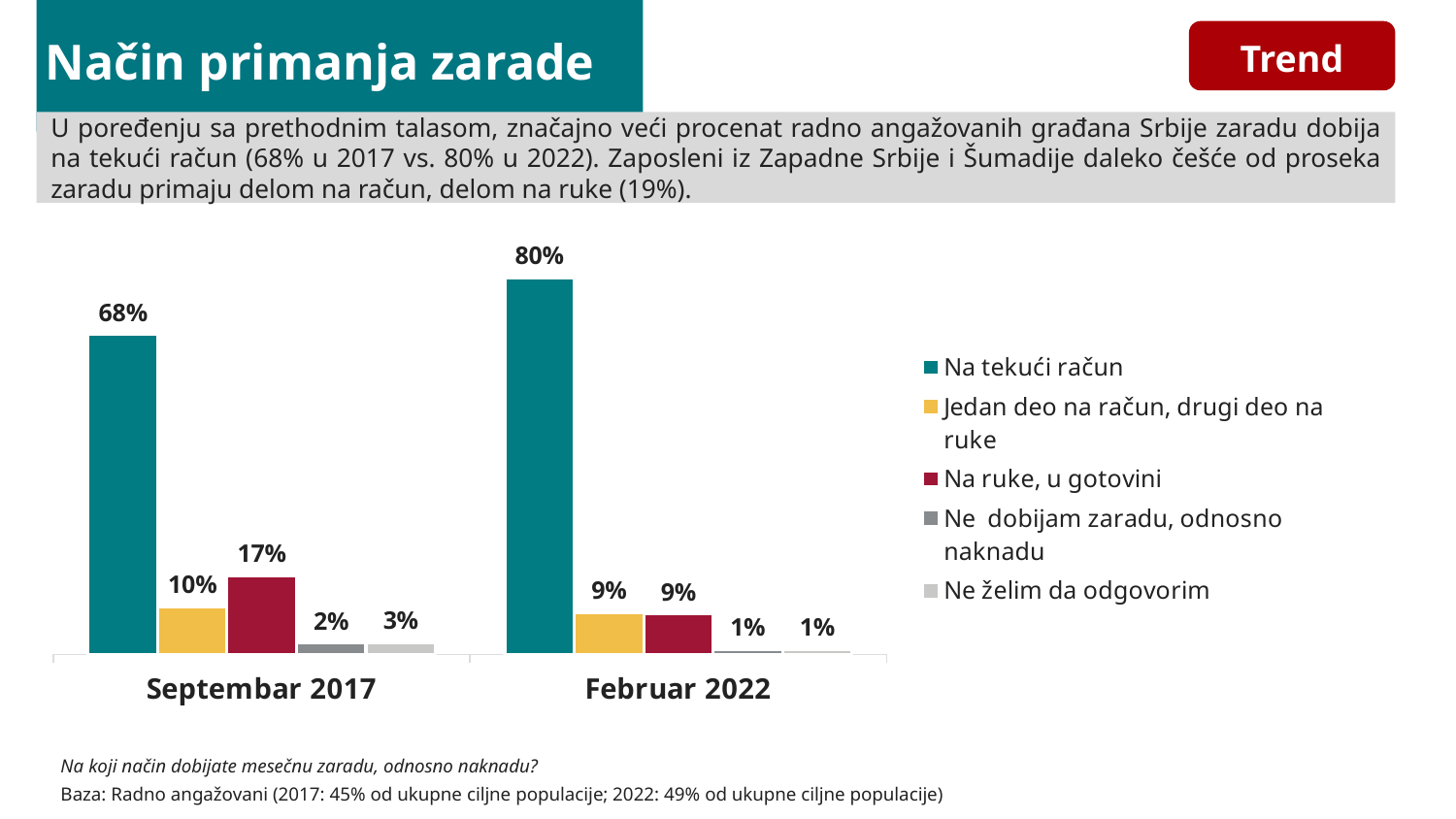
What is the value for "Ne želim da odgovorim" in Septembar 2017? 3% What kind of chart is shown on the slide? bar chart What is the difference between the "Na tekući račun" values for Februar 2022 and Septembar 2017? 12% What is the value for "Na tekući račun" in Februar 2022? 80% Which is larger: "Na ruke, u gotovini" in Septembar 2017 or in Februar 2022? Septembar 2017 Which series has the lowest value in Septembar 2017? Ne dobijam zaradu, odnosno naknadu How many categories are shown on the x axis? 2 How many series does the legend list? 5 What is the value for "Na ruke, u gotovini" in Septembar 2017? 17% What is the value for "Jedan deo na račun, drugi deo na ruke" in Februar 2022? 9% What is the value for "Na tekući račun" in Septembar 2017? 68% Which series has the highest value in Februar 2022? Na tekući račun